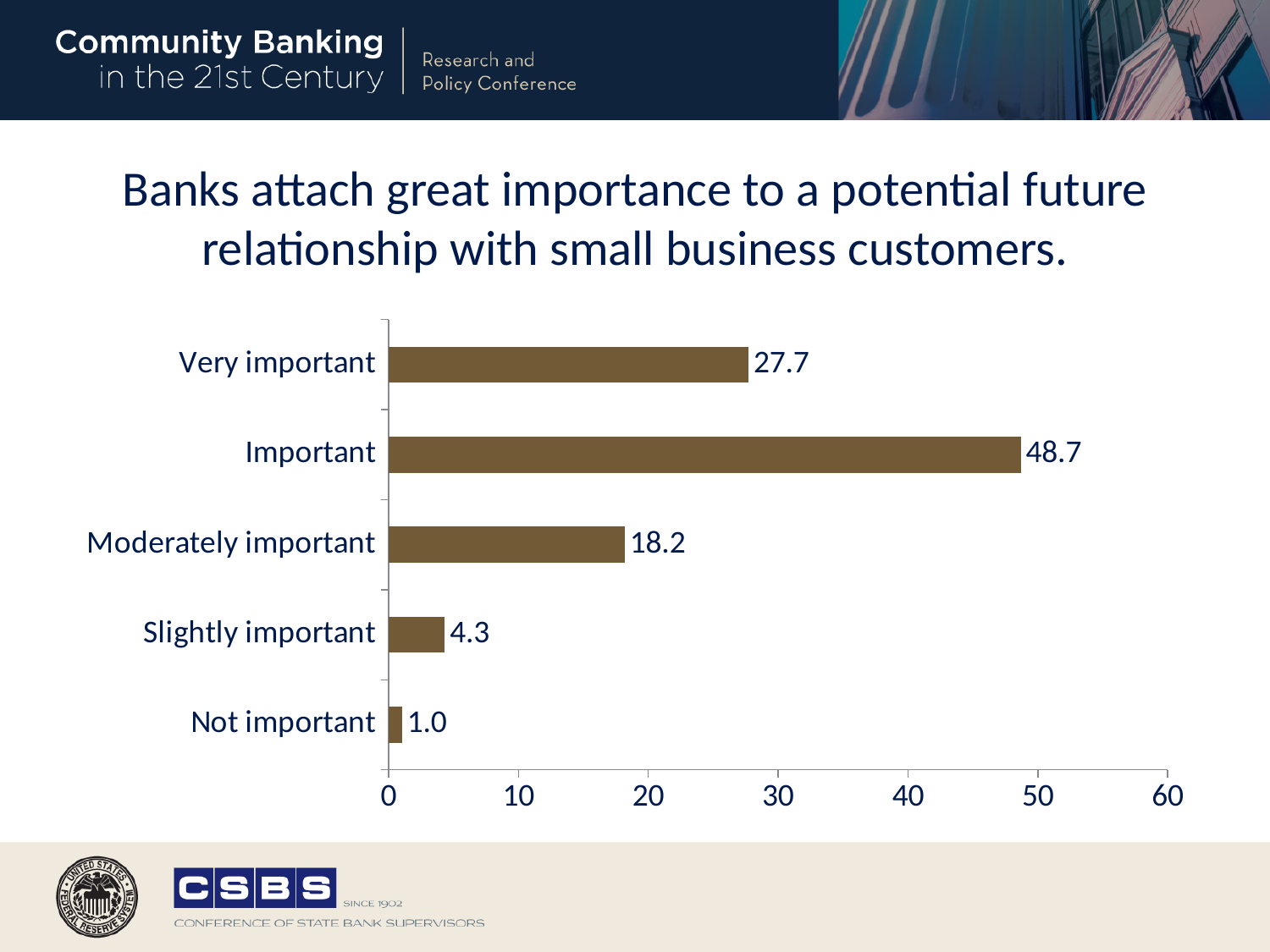
What kind of chart is shown on the slide? bar chart Which category has the highest value? Important What is the value for Important? 48.7 How many categories are shown in the chart? 5 Which category has the lowest value? Not important What is the value for Very important? 27.7 What is the value for Moderately important? 18.2 Is the value for Important greater or less than 40? greater What is the value for Slightly important? 4.3 What is the difference between the values for Important and Very important? 21.0 What is the value for Not important? 1.0 Which is larger, the value for Moderately important or the value for Slightly important? Moderately important